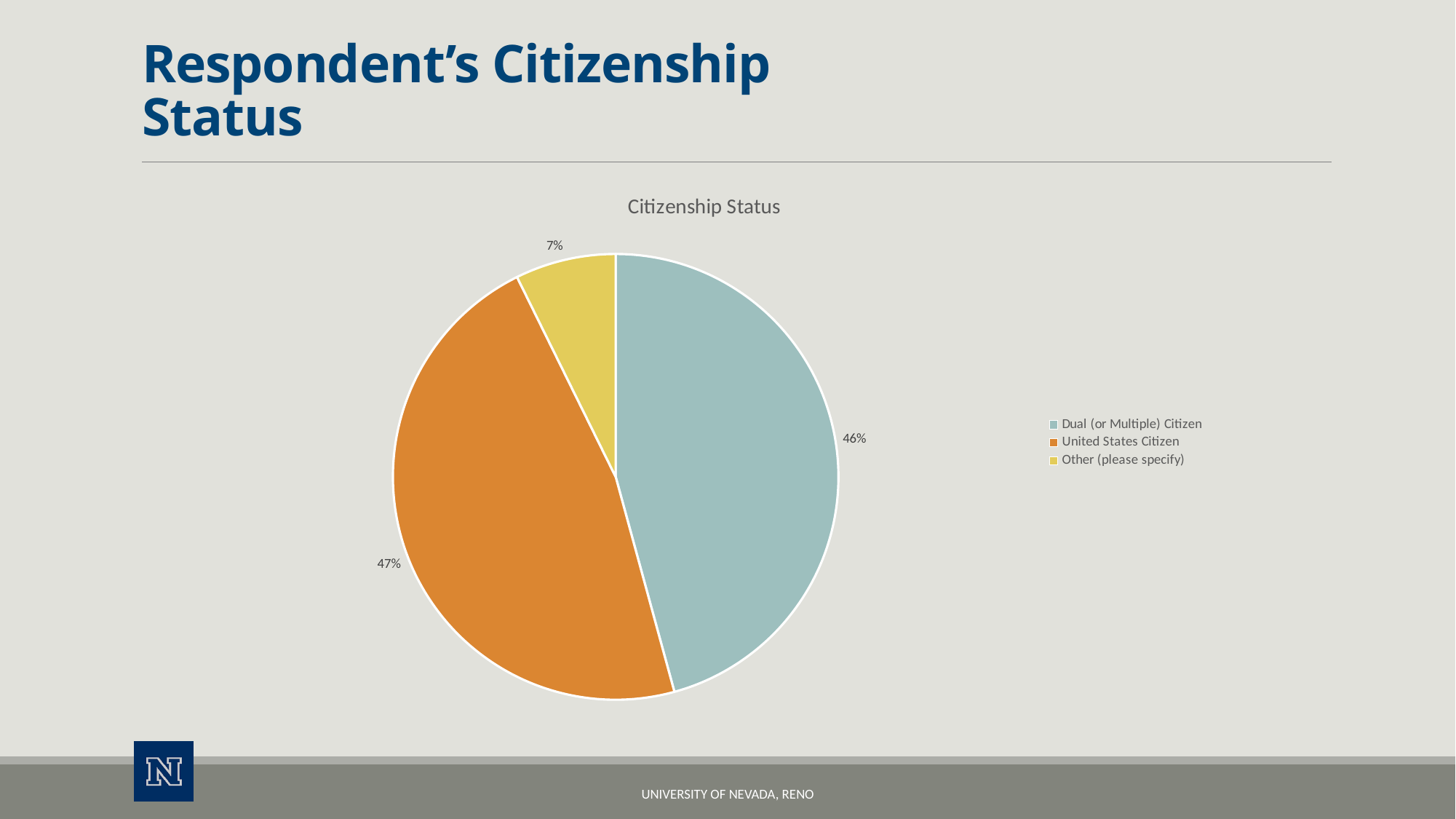
What percentage of respondents are United States Citizens? 47% What percentage of respondents selected Other (please specify)? 7% What is the difference in percentage points between Dual (or Multiple) Citizen and Other (please specify)? 39 What is the title of the chart? Citizenship Status How many slices does the pie chart have? 3 Which is larger: the share for Dual (or Multiple) Citizen or the share for Other (please specify)? Dual (or Multiple) Citizen What percentage of respondents are Dual (or Multiple) Citizens? 46% Which citizenship category has the smallest share of the pie? Other (please specify) What type of chart is shown on the slide? pie chart What is the difference in percentage points between United States Citizen and Other (please specify)? 40 How many categories does the legend list? 3 Which colour represents United States Citizen in the chart? orange